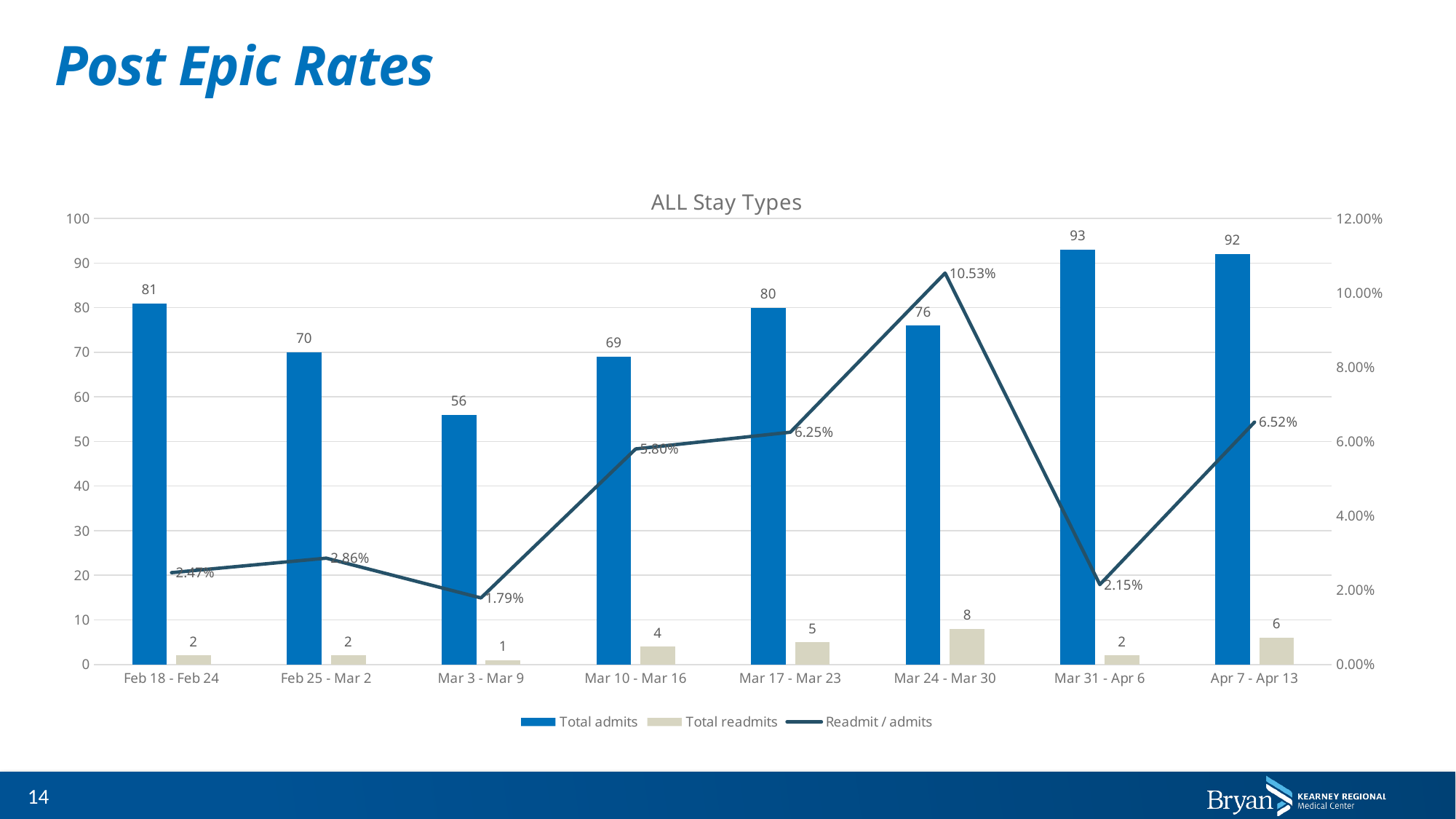
How many series does the legend list? 3 Which week has the lowest Readmit / admits rate? Mar 3 - Mar 9 Which is larger, Total readmits for Mar 24 - Mar 30 or for Apr 7 - Apr 13? Mar 24 - Mar 30 What is the Readmit / admits rate for Mar 24 - Mar 30? 10.53% Does the Readmit / admits rate rise or fall from Mar 24 - Mar 30 to Mar 31 - Apr 6? Fall What is the title of the chart? ALL Stay Types Which week has the highest Total admits? Mar 31 - Apr 6 What kind of chart is this? Combined bar and line chart How many weeks are shown on the x axis? 8 What is the difference in Total admits between Feb 18 - Feb 24 and Feb 25 - Mar 2? 11 What is the value of Total readmits for Mar 17 - Mar 23? 5 What is the value of Total admits for Mar 3 - Mar 9? 56